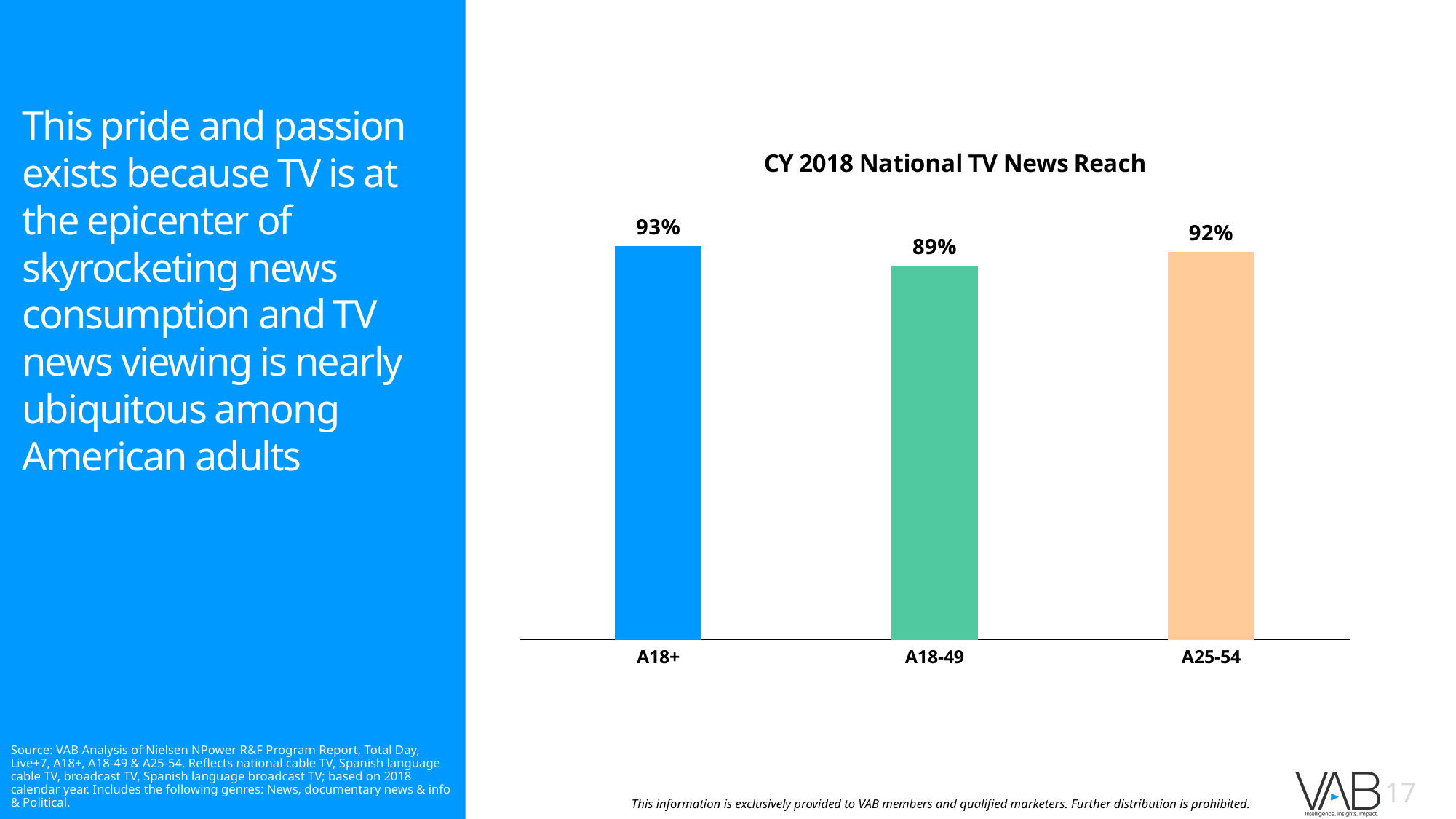
Which has a higher reach, A18-49 or A25-54? A25-54 What is the difference in reach between A18+ and A18-49? 4% Which demographic has the lowest National TV News Reach? A18-49 What is the CY 2018 National TV News Reach for A18+? 93% Which demographic has the highest National TV News Reach? A18+ What colour is the bar for A18-49? Green What is the difference in reach between A25-54 and A18-49? 3% What is the CY 2018 National TV News Reach for A25-54? 92% How many demographic categories are shown in the chart? 3 What is the title of the chart? CY 2018 National TV News Reach What type of chart is shown on the slide? Bar chart What is the CY 2018 National TV News Reach for A18-49? 89%